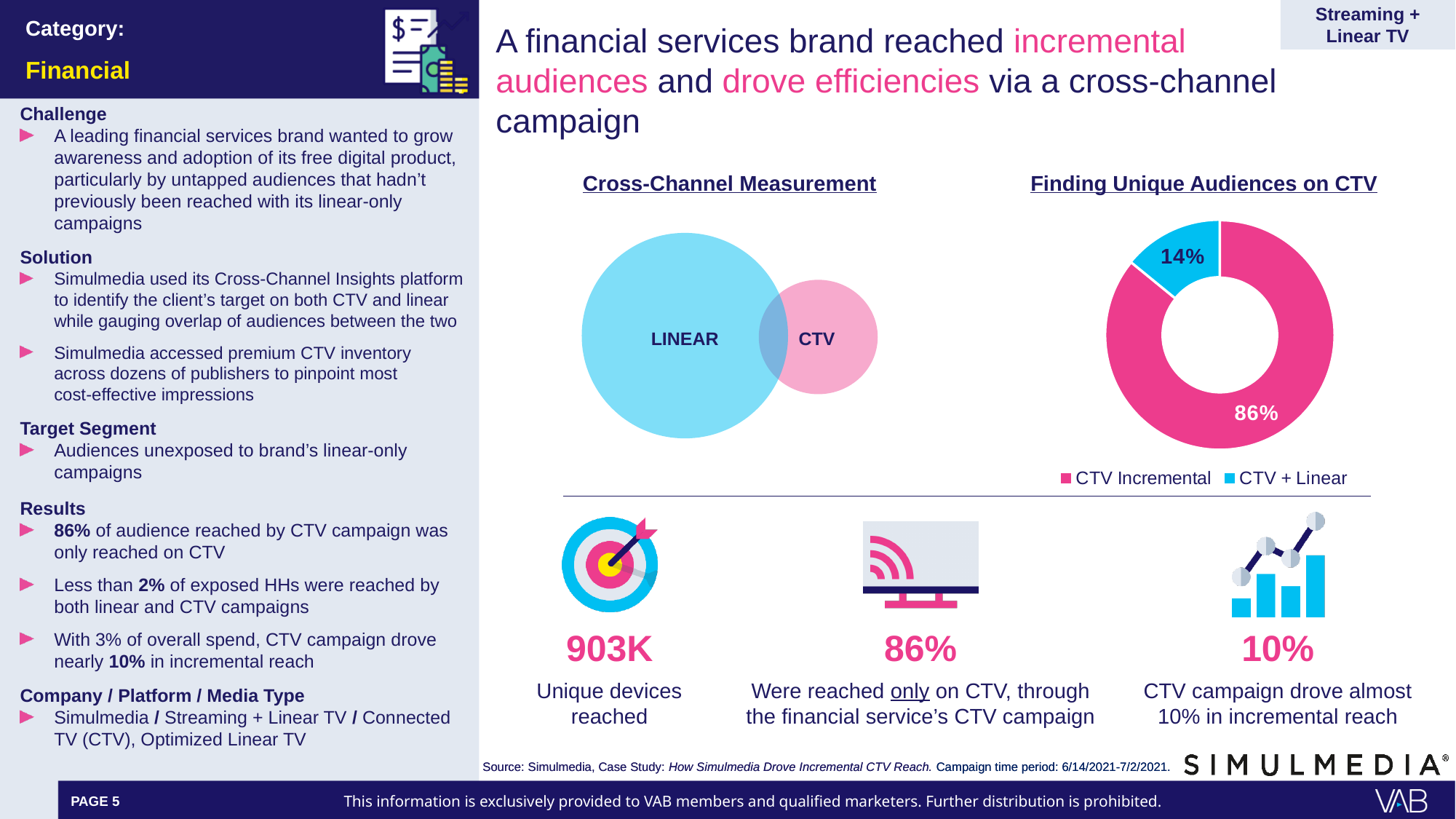
In the 'Finding Unique Audiences on CTV' chart, what colour is the CTV + Linear segment? Blue In the 'Finding Unique Audiences on CTV' chart, which segment is the smallest? CTV + Linear What kind of chart is 'Finding Unique Audiences on CTV'? Donut (pie) chart In the 'Finding Unique Audiences on CTV' chart, what share is CTV + Linear? 14% In the 'Finding Unique Audiences on CTV' chart, which segment is the largest? CTV Incremental In the 'Finding Unique Audiences on CTV' chart, what colour is the CTV Incremental segment? Pink In the 'Finding Unique Audiences on CTV' chart, which is larger: CTV Incremental or CTV + Linear? CTV Incremental In the 'Finding Unique Audiences on CTV' chart, what share is CTV Incremental? 86% In the 'Finding Unique Audiences on CTV' chart, what is the difference in percentage points between CTV Incremental and CTV + Linear? 72 In the 'Finding Unique Audiences on CTV' chart, do the two segments add up to 100%? Yes How many segments does the 'Finding Unique Audiences on CTV' chart have? 2 How many entries does the legend of the 'Finding Unique Audiences on CTV' chart list? 2